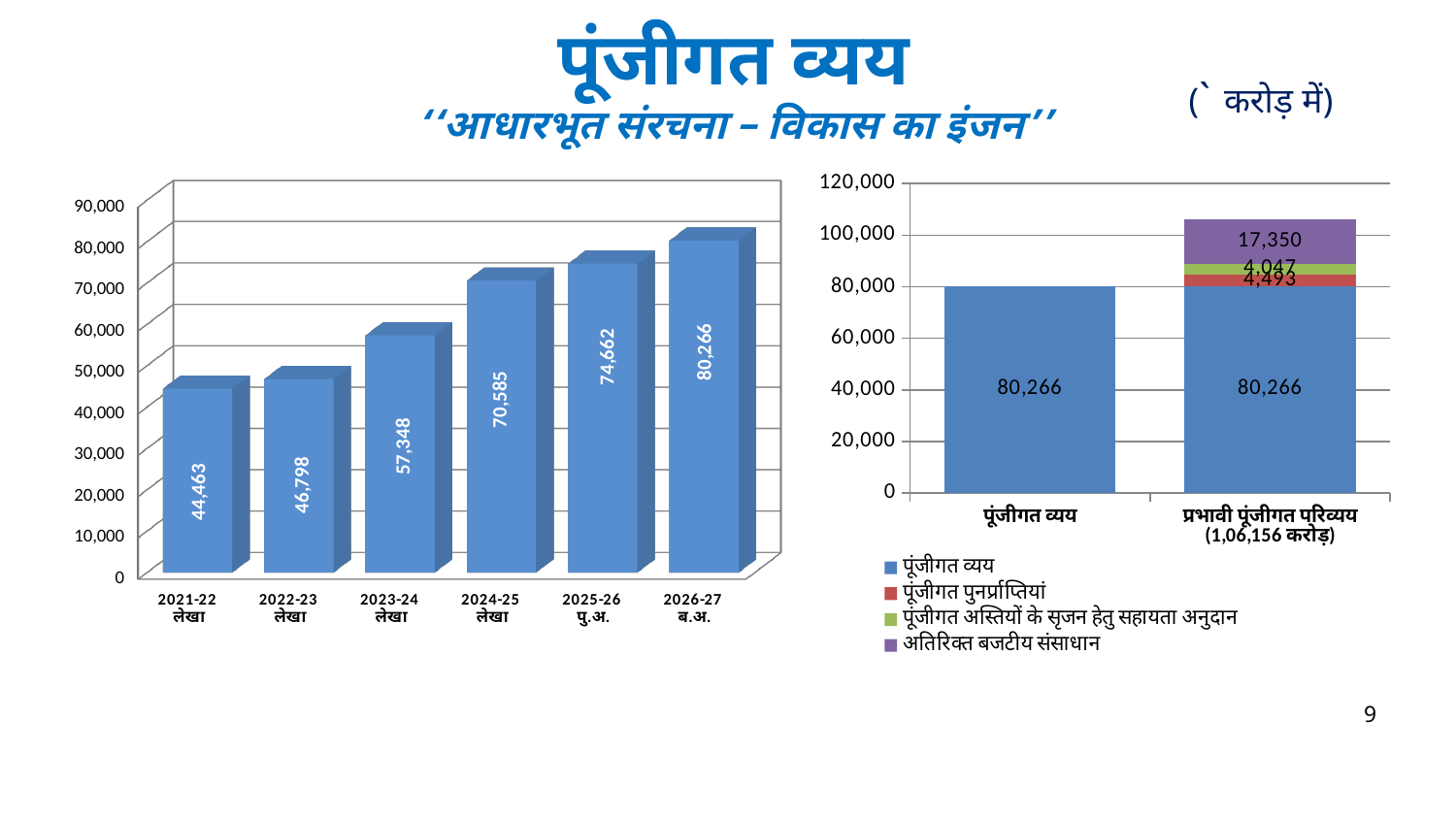
What kind of chart is the left chart? bar chart How many bars are shown in the left chart? 6 In the right chart, what is the total of the stacked प्रभावी पूंजीगत परिव्यय bar? 1,06,156 In the left chart, which year has the lowest value? 2021-22 लेखा In the left chart, what is the value for 2025-26 पु.अ.? 74,662 In the left chart, what is the difference between the values for 2024-25 लेखा and 2023-24 लेखा? 13,237 How many series does the legend of the right chart list? 4 In the left chart, which year has the highest value? 2026-27 ब.अ. In the right chart, what is the value of the अतिरिक्त बजटीय संसाधन segment in the प्रभावी पूंजीगत परिव्यय bar? 17,350 In the left chart, do the values rise or fall from 2021-22 to 2026-27? rise In the left chart, what is the value for 2023-24 लेखा? 57,348 In the right chart, which is larger: the पूंजीगत पुनर्प्राप्तियां segment or the पूंजीगत अस्तियों के सृजन हेतु सहायता अनुदान segment? पूंजीगत पुनर्प्राप्तियां